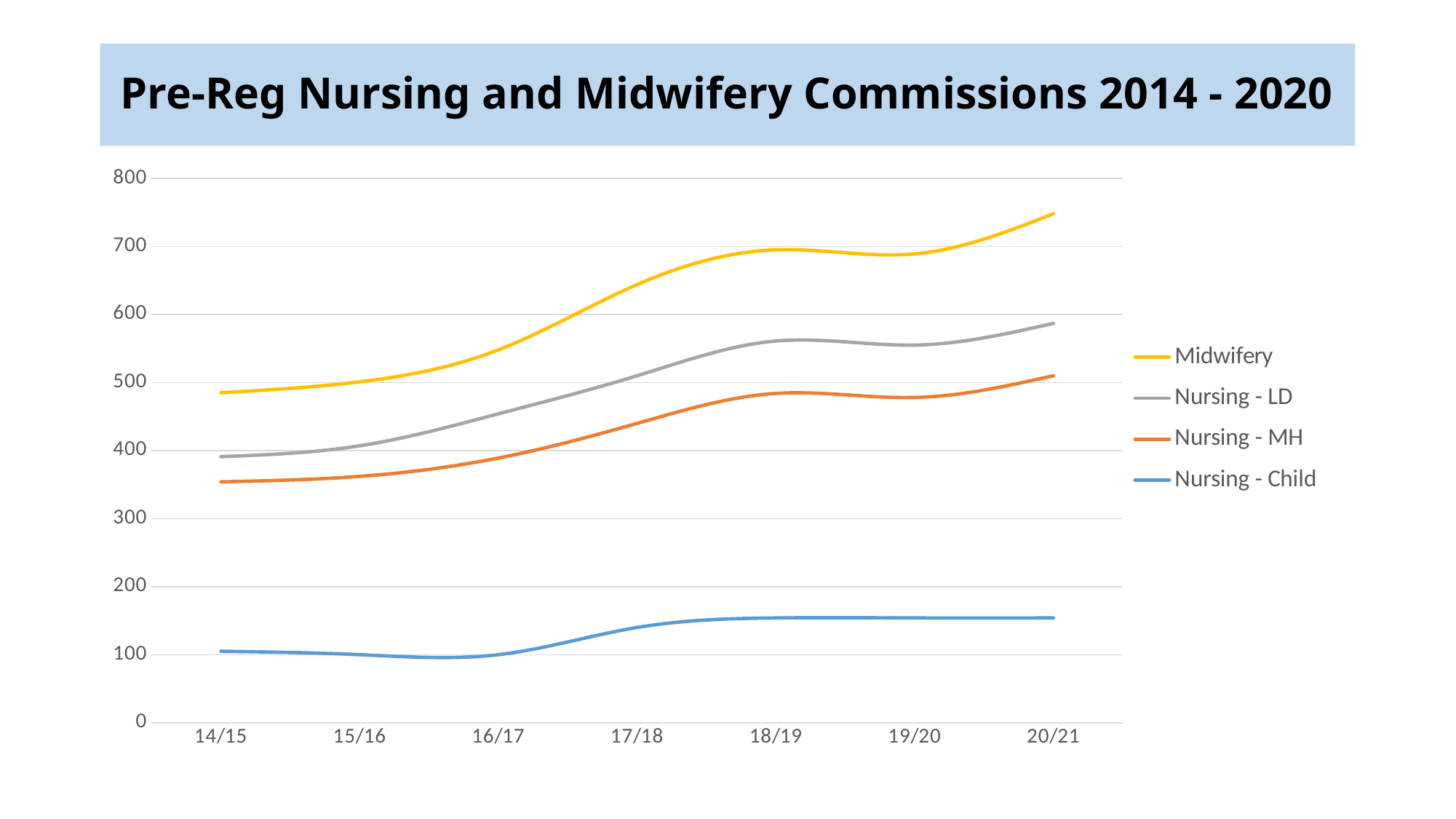
What kind of chart is shown on the slide? line chart What is the title of the chart? Pre-Reg Nursing and Midwifery Commissions 2014 - 2020 Is the value for Nursing - Child in 14/15 greater or less than 200? less How many series does the legend list? 4 Is the value for Nursing - MH in 14/15 greater or less than 400? less In 17/18, which is larger: Midwifery or Nursing - LD? Midwifery How many academic years are shown along the x axis? 7 Does the Midwifery line rise or fall overall from 14/15 to 20/21? rise